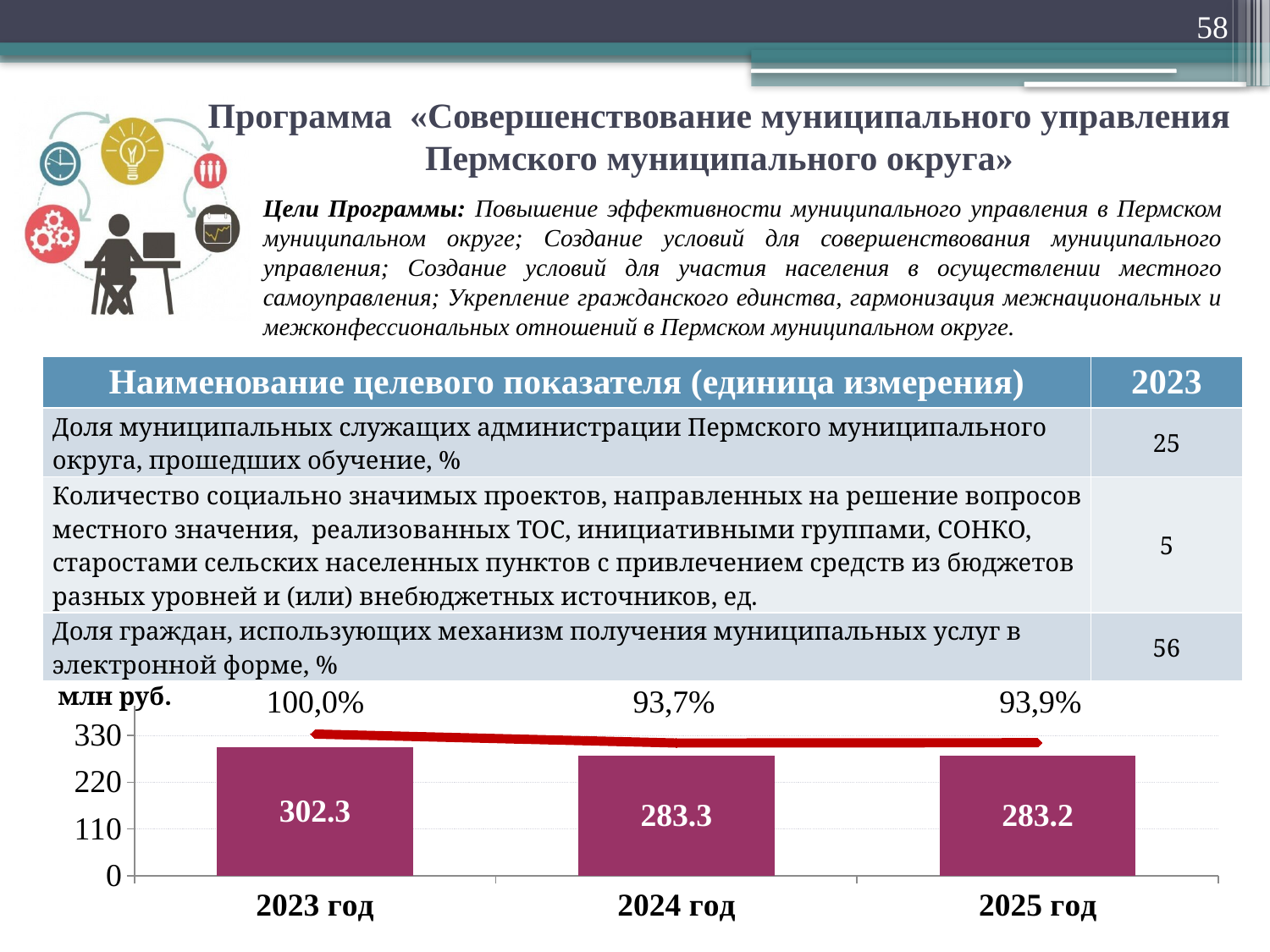
Do the values rise or fall from 2023 год to 2025 год? fall What kind of chart is shown at the bottom of the slide? combination bar and line chart Which year has the highest value in the bar chart? 2023 год What is the difference between the values for 2023 год and 2024 год? 19.0 Is the value for 2024 год greater or less than 220? greater What is the value for 2024 год in the bar chart? 283.3 How many bars are shown in the chart? 3 What is the value for 2025 год in the bar chart? 283.2 What is the value for 2023 год in the bar chart? 302.3 What percentage is shown above the 2024 год bar? 93,7% Is the value for 2023 год greater or less than 330? less Which is larger, the value for 2023 год or the value for 2025 год? 2023 год